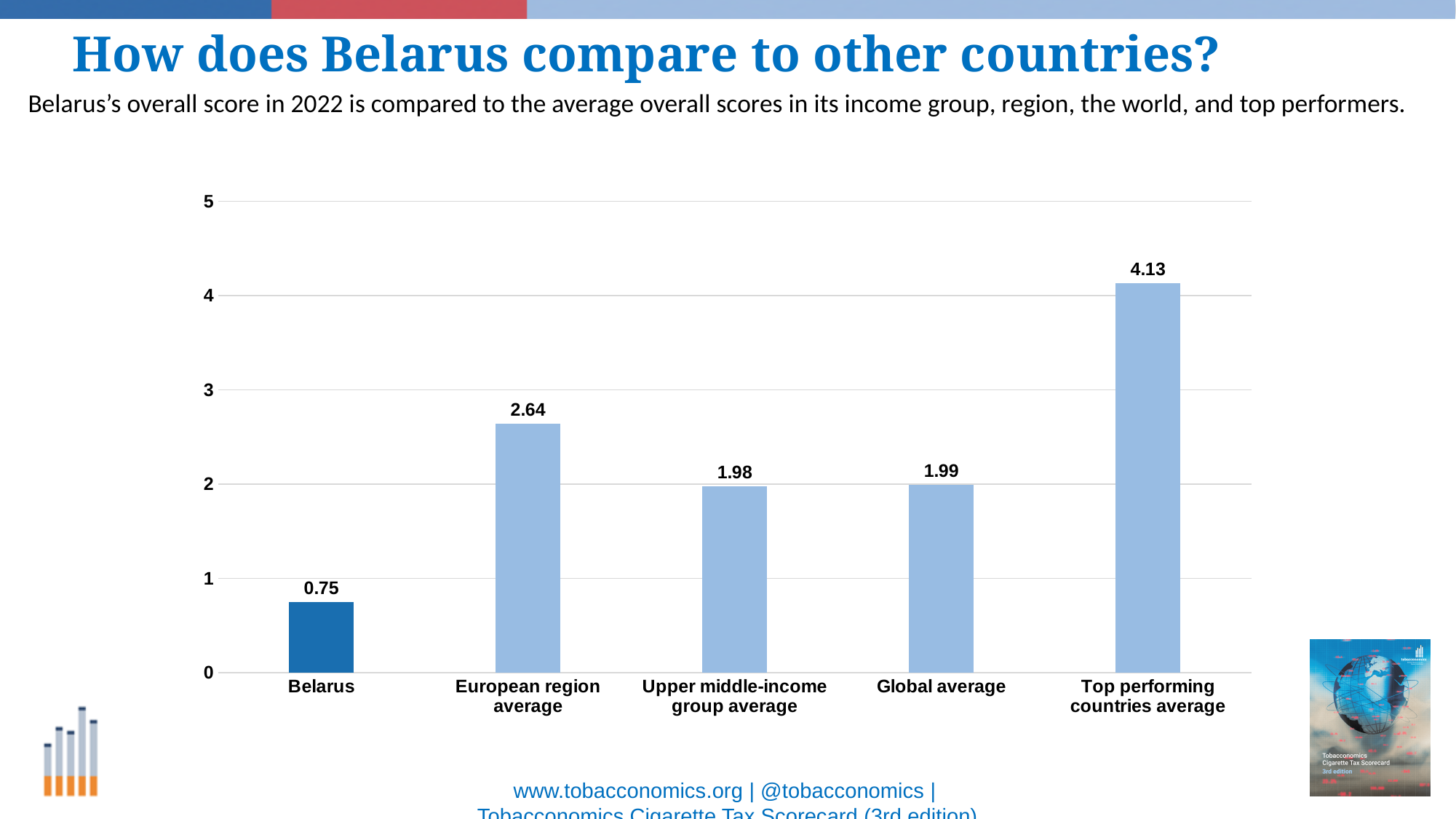
What is the value for the Top performing countries average? 4.13 What is the value for the European region average? 2.64 What is the difference between the Top performing countries average and Belarus? 3.38 What is the value for the Upper middle-income group average? 1.98 What kind of chart is shown on the slide? Bar chart What is the value for Belarus? 0.75 Which category has the lowest value? Belarus What is the difference between the European region average and the Global average? 0.65 Which is larger, the European region average or the Global average? European region average Which bar is shown in a darker blue than the others? Belarus How many categories are shown on the chart? 5 Which category has the highest value? Top performing countries average